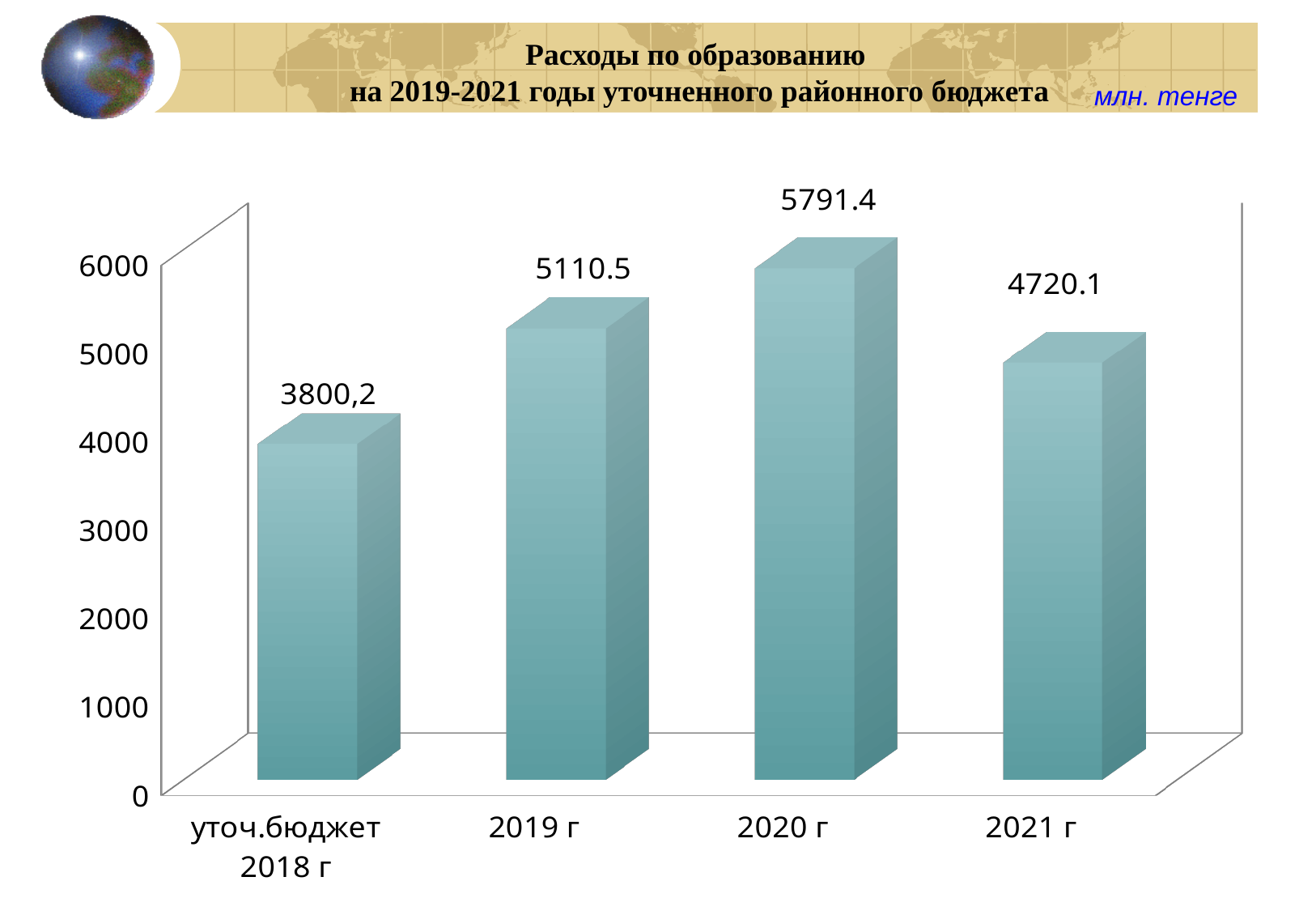
What is the value shown for уточ.бюджет 2018 г? 3800,2 What is the difference between the values for 2020 г and 2019 г? 680.9 What kind of chart is shown on the slide? bar chart Is the value for 2021 г greater or less than 5000? less Which is larger, the value for 2019 г or the value for 2021 г? 2019 г What is the value shown for 2021 г? 4720.1 What is the value shown for 2019 г? 5110.5 What is the difference between the values for 2020 г and 2021 г? 1071.3 Which category has the lowest value? уточ.бюджет 2018 г Which year has the highest value? 2020 г In what units are the values on the chart expressed? млн. тенге How many bars are shown in the chart? 4